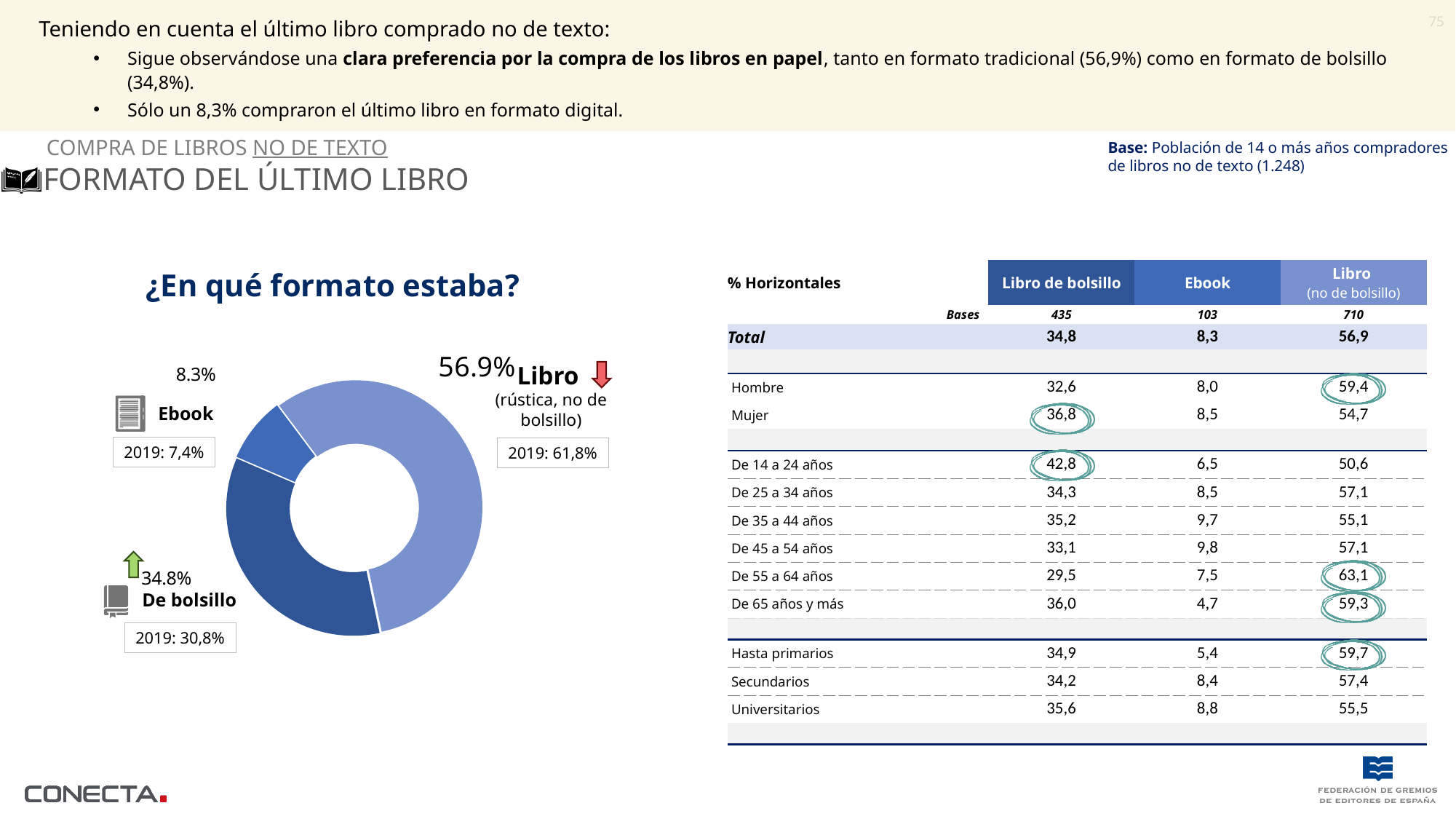
In the '¿En qué formato estaba?' chart, what is the difference in percentage points between De bolsillo (34.8%) and Ebook (8.3%)? 26.5 In the '¿En qué formato estaba?' chart, what percentage is shown for Ebook? 8.3% In the '¿En qué formato estaba?' chart, what percentage is shown for De bolsillo? 34.8% In the '¿En qué formato estaba?' chart, which format has the smallest slice? Ebook In the '¿En qué formato estaba?' chart, which format has the largest slice? Libro (rústica, no de bolsillo) What is the title of the donut chart on the left of the slide? ¿En qué formato estaba? How many slices does the '¿En qué formato estaba?' chart have? 3 What kind of chart is shown under the title '¿En qué formato estaba?'? pie chart (donut) In the '¿En qué formato estaba?' chart, what 2019 value is shown in the box next to Libro? 2019: 61,8% In the '¿En qué formato estaba?' chart, which is larger: the share for De bolsillo or the share for Ebook? De bolsillo In the '¿En qué formato estaba?' chart, what percentage is shown for Libro (rústica, no de bolsillo)? 56.9% In the '¿En qué formato estaba?' chart, what is the difference in percentage points between Libro (56.9%) and De bolsillo (34.8%)? 22.1